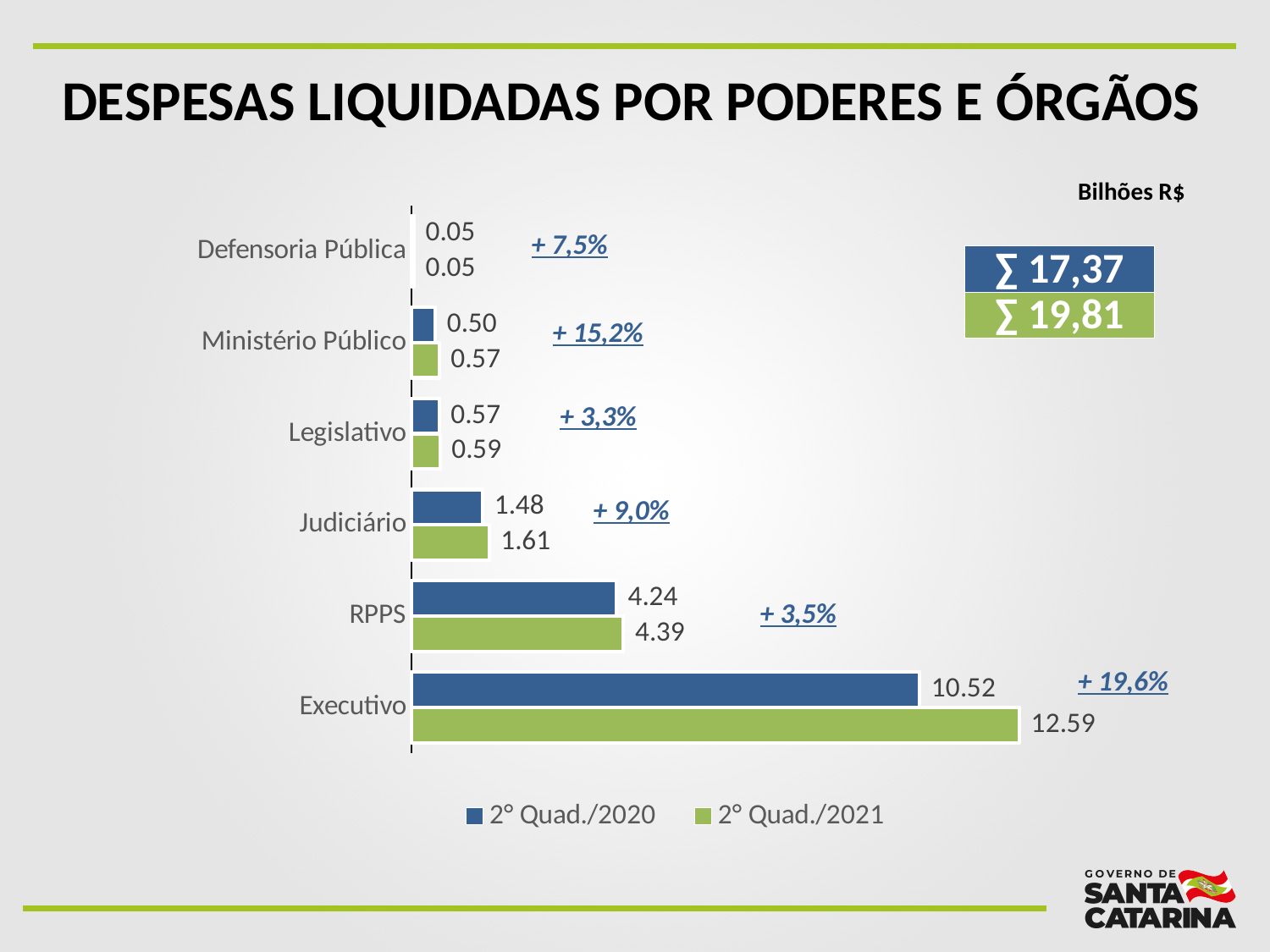
What is the value for Ministério Público in the 2° Quad./2020 series? 0.50 Which is larger: the 2° Quad./2020 value for RPPS or the 2° Quad./2021 value for Judiciário? 2° Quad./2020 value for RPPS What is the value for Executivo in the 2° Quad./2021 series? 12.59 What is the difference between the 2° Quad./2021 and 2° Quad./2020 values for Executivo? 2.07 Which category has the highest value in the 2° Quad./2021 series? Executivo How many series does the legend list? 2 How many categories are shown on the chart? 6 What is the value for RPPS in the 2° Quad./2020 series? 4.24 What percentage change is annotated for Ministério Público? + 15,2% What kind of chart is shown on the slide? Bar chart Which category has the lowest value in the 2° Quad./2020 series? Defensoria Pública What is the value for Judiciário in the 2° Quad./2021 series? 1.61